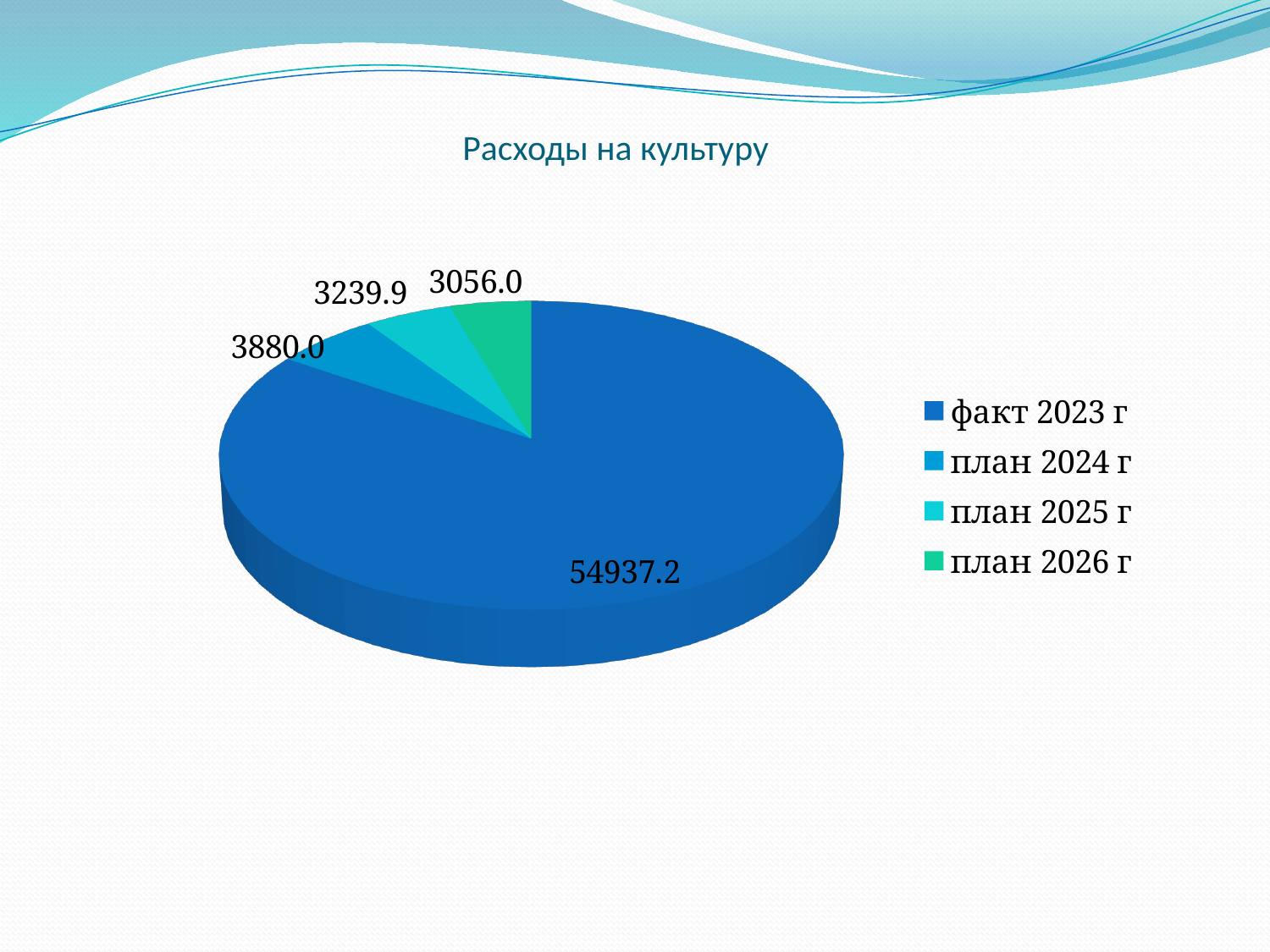
What is the value for план 2026 г? 3056.0 What is the difference between план 2024 г and план 2025 г? 640.1 Which is larger, план 2025 г or план 2026 г? план 2025 г What is the value for факт 2023 г? 54937.2 Which category has the smallest slice? план 2026 г What is the value for план 2024 г? 3880.0 What is the difference between факт 2023 г and план 2024 г? 51057.2 What kind of chart is shown on the slide? Pie chart What is the value for план 2025 г? 3239.9 How many slices does the pie chart have? 4 What is the title of the chart? Расходы на культуру Which category has the largest slice? факт 2023 г